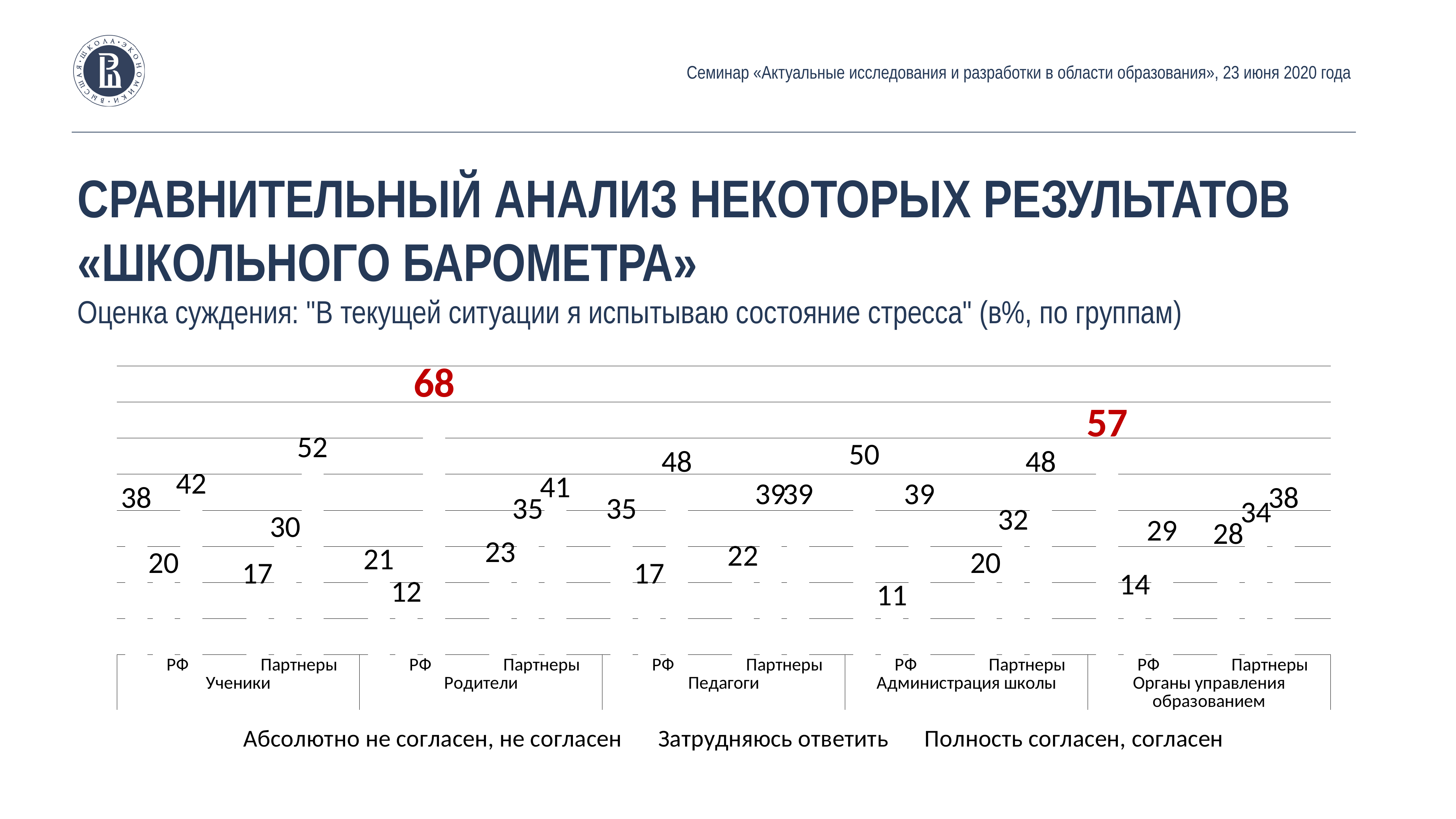
In which group and subgroup does the highlighted value 68 appear? Родители, РФ What is the lowest value labelled on the chart? 11 What is the first legend entry of the chart? Абсолютно не согласен, не согласен What is the highest value labelled on the chart? 68 What is the difference between the two highlighted values, 68 and 57? 11 Which two subgroups are shown within each respondent group? РФ and Партнеры What kind of chart is shown on the slide? bar chart How many respondent groups are shown along the x axis (Ученики, Родители, etc.)? 5 Which is larger: the highlighted value for Родители РФ (68) or for Органы управления образованием РФ (57)? Родители РФ (68) What is the last legend entry of the chart? Полность согласен, согласен How many series does the legend list? 3 In which group and subgroup does the highlighted value 57 appear? Органы управления образованием, РФ